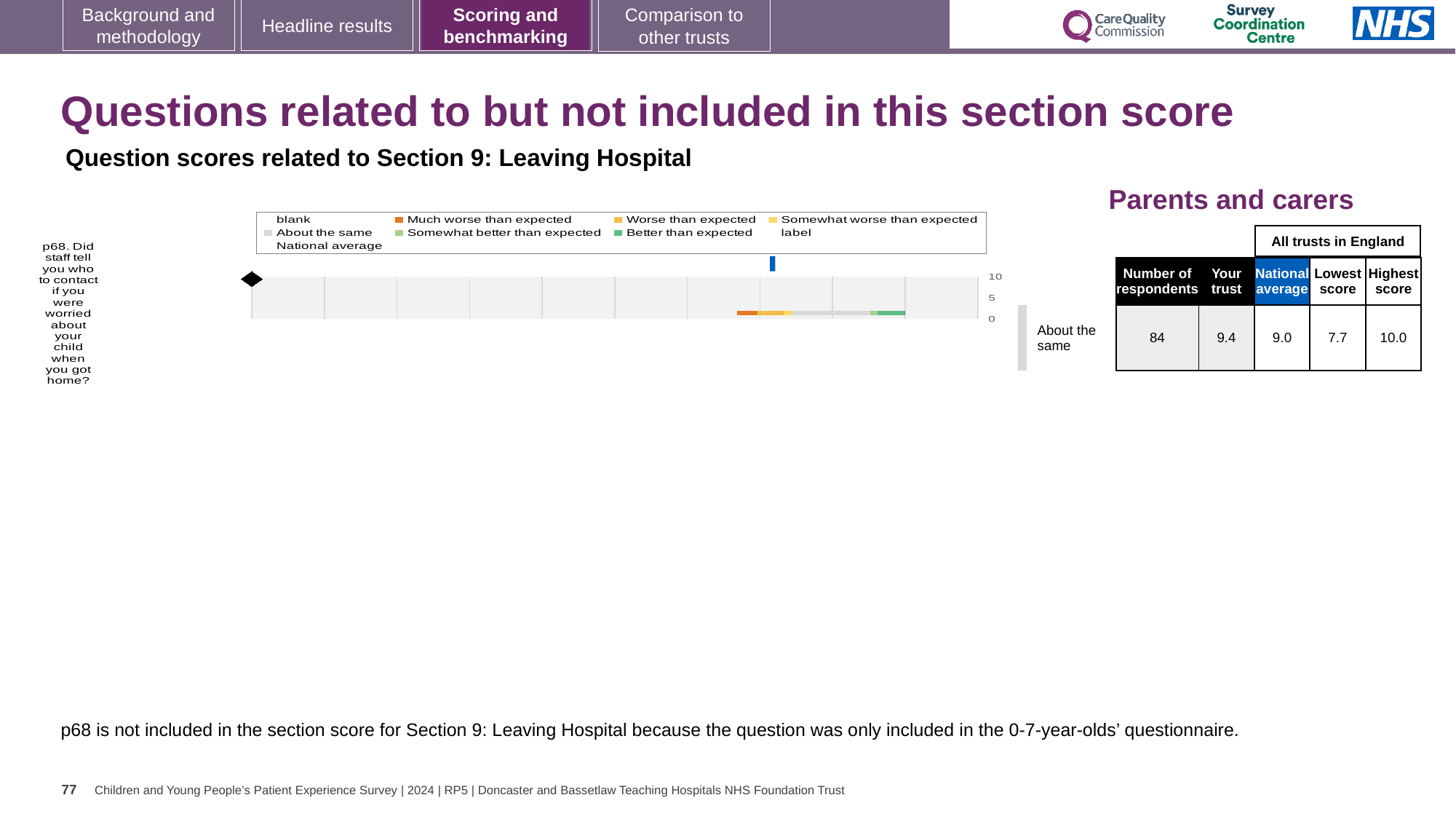
In the table beside the chart, how many respondents answered p68? 84 In the table beside the chart, what is the 'Your trust' score for p68? 9.4 What is the highest value shown on the chart's axis? 10 In the table beside the chart, what is the Highest score among all trusts in England for p68? 10.0 Which question is plotted in the chart? p68. Did staff tell you who to contact if you were worried about your child when you got home? What benchmark category is shown for p68 next to the chart? About the same In the table beside the chart, what is the National average score for p68? 9.0 How many entries does the chart legend list? 9 How many questions (categories) are plotted in the chart? 1 In the table beside the chart, what is the Lowest score among all trusts in England for p68? 7.7 What kind of chart is shown on the slide? bar chart Is the 'Your trust' score for p68 larger or smaller than the National average? larger